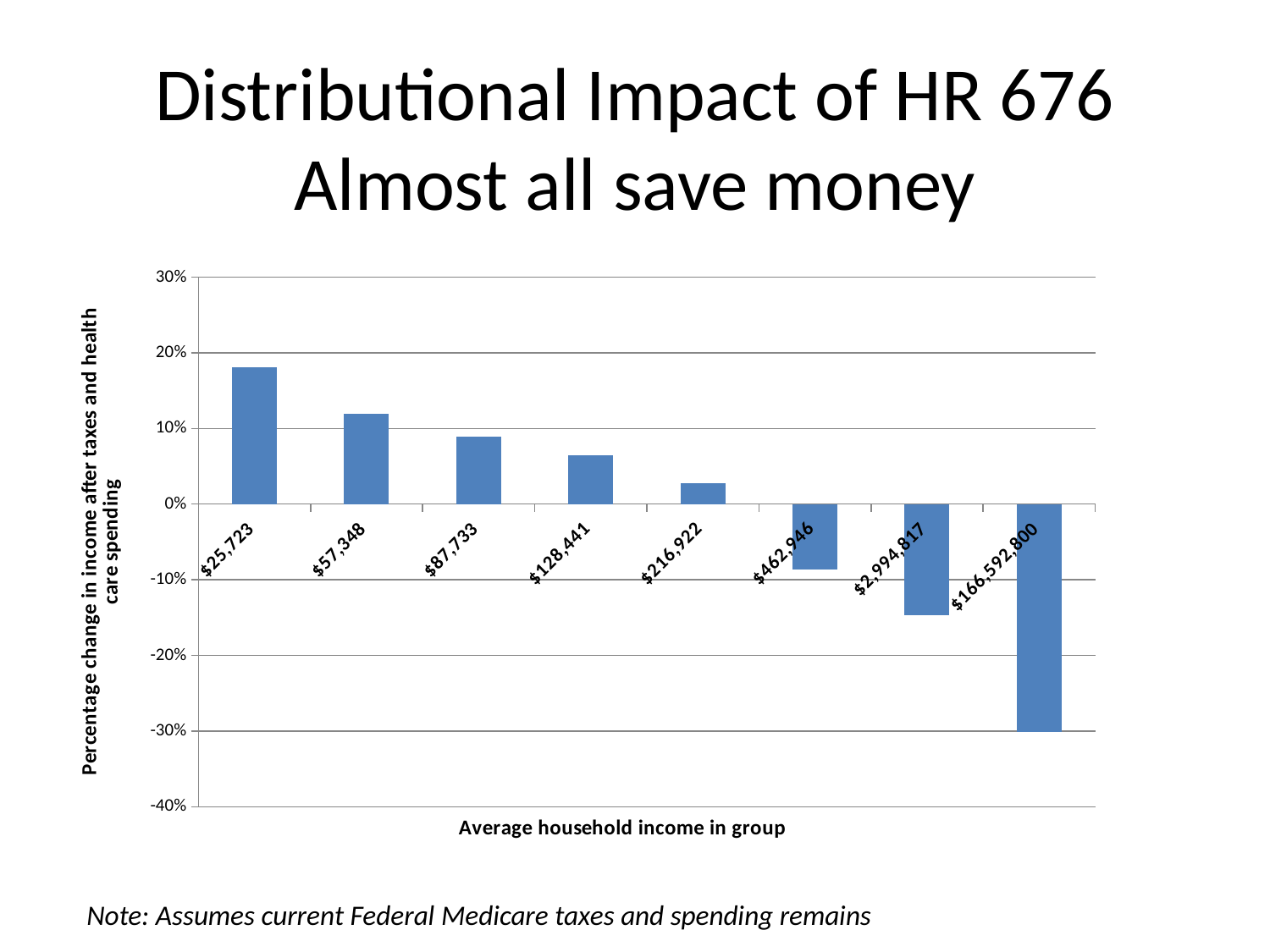
Is the value for the $25,723 group greater or less than 10%? greater Is the value for the $166,592,800 group greater or less than -20%? less Is the value for the $57,348 group greater or less than 10%? greater Which income group has the highest percentage change in income? $25,723 Do the values rise or fall as average household income increases along the x axis? fall What is the title of the x axis of the chart? Average household income in group Which income group has the lowest percentage change in income? $166,592,800 How many income groups (bars) are plotted in the chart? 8 Which has the larger percentage change in income: the $87,733 group or the $128,441 group? $87,733 What kind of chart is shown on the slide? bar chart